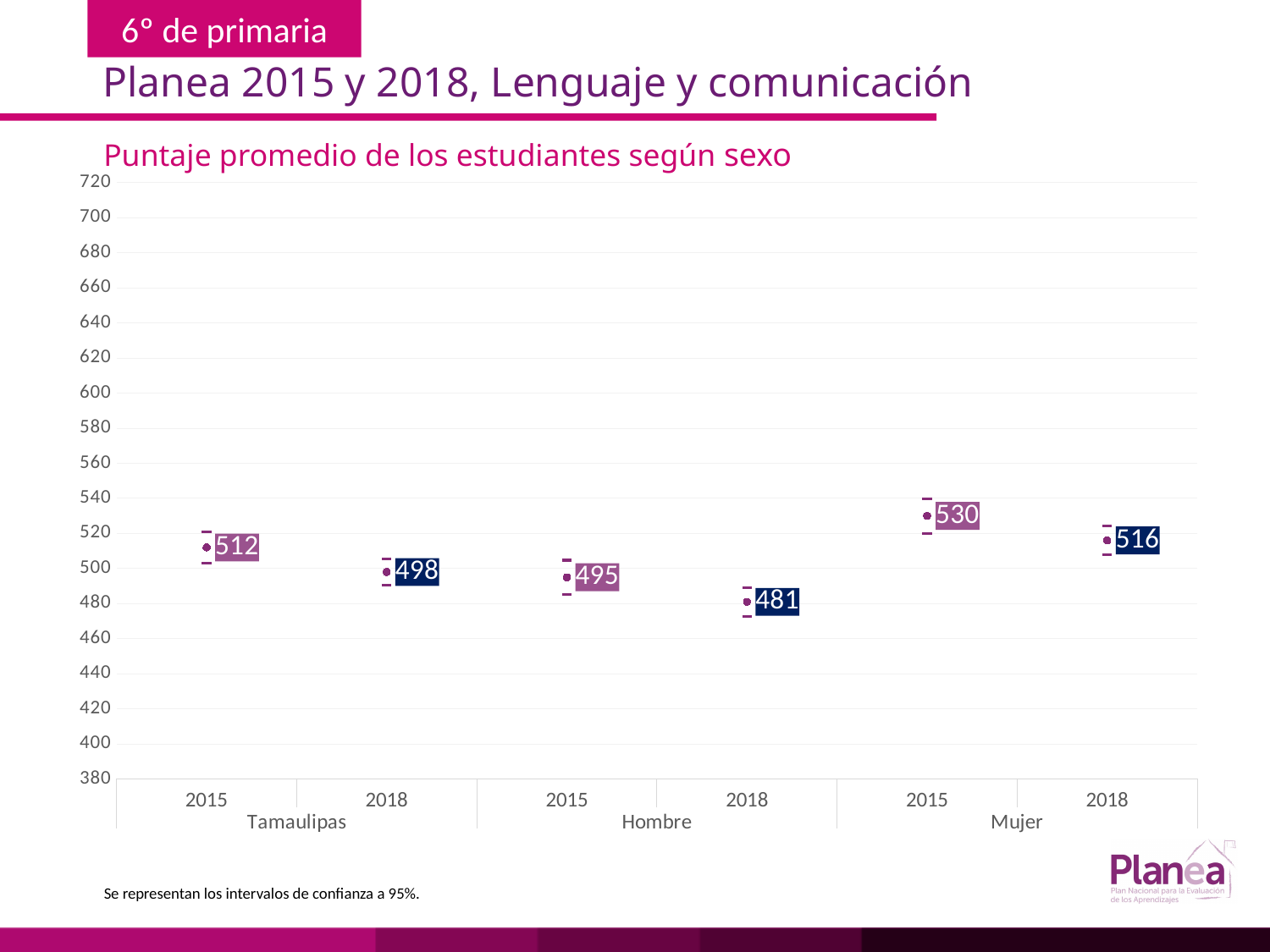
What is the average score for Mujer in 2018? 516 What is the difference between the Mujer and Hombre scores in 2018? 35 What is the average score for Tamaulipas in 2015? 512 How many data points are plotted on the chart? 6 What is the average score for Mujer in 2015? 530 Which group and year has the lowest average score? Hombre 2018 Which group and year has the highest average score? Mujer 2015 Which is larger, the Tamaulipas score in 2018 or the Hombre score in 2015? Tamaulipas 2018 What is the average score for Hombre in 2018? 481 What is the title of the chart? Puntaje promedio de los estudiantes según sexo What is the difference between the Mujer score in 2015 and in 2018? 14 Did the Hombre score rise or fall from 2015 to 2018? fall